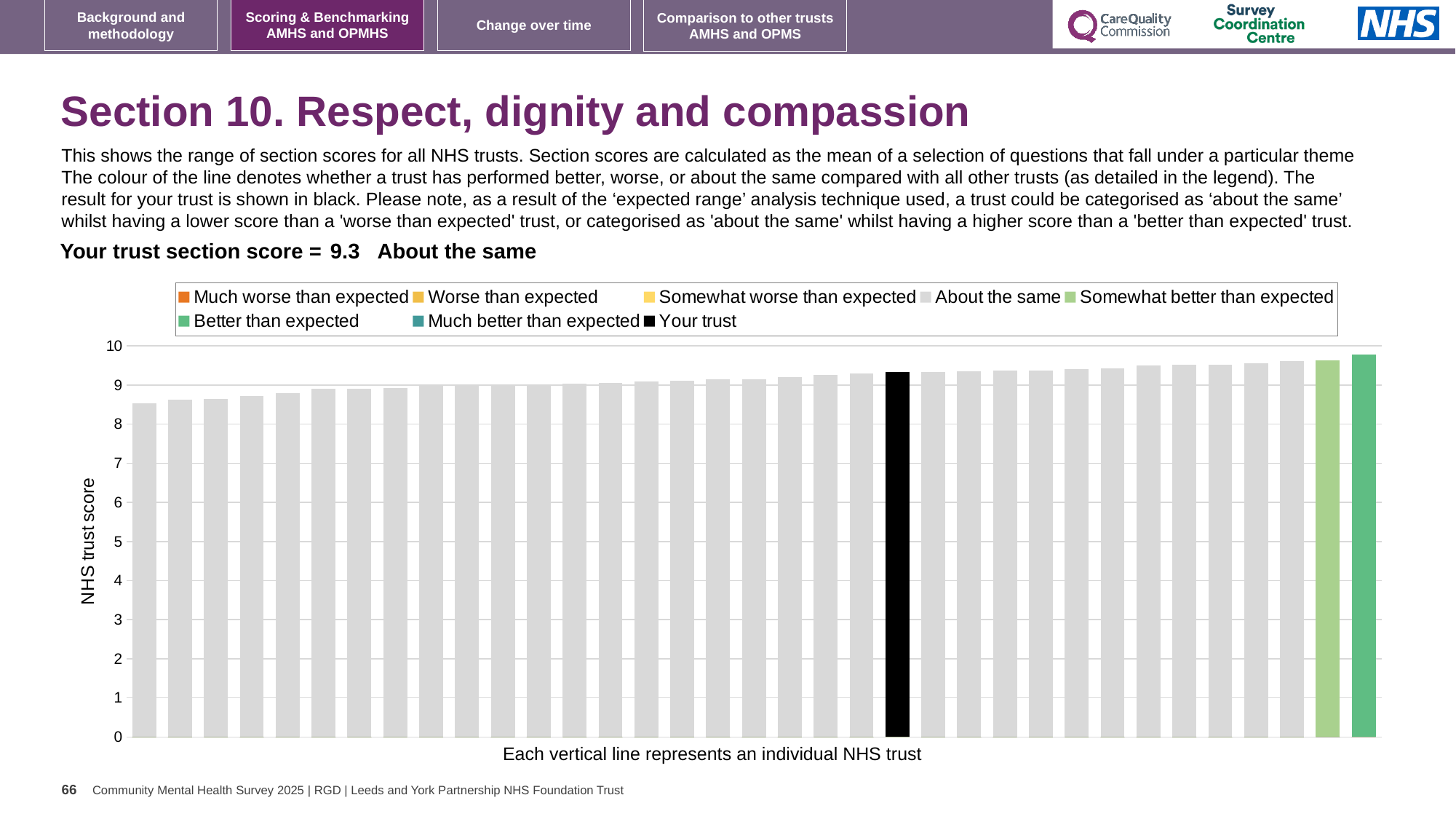
Which legend category is your trust placed in? About the same How many entries does the chart legend list? 8 What is the label on the vertical axis of the chart? NHS trust score Do the bar values rise or fall from left to right along the x axis? rise Is the value of the leftmost (lowest) bar greater or less than 9? less What is the section score for your trust shown on the slide? 9.3 Is the value for the black 'Your trust' bar greater or less than 9? greater What kind of chart is shown on the slide? bar chart How many bars are coloured as 'Somewhat better than expected'? 1 Which legend category does the highest bar in the chart belong to? Better than expected Which legend category does the lowest bar in the chart belong to? About the same Is the 'Your trust' bar higher or lower than the rightmost bar? lower